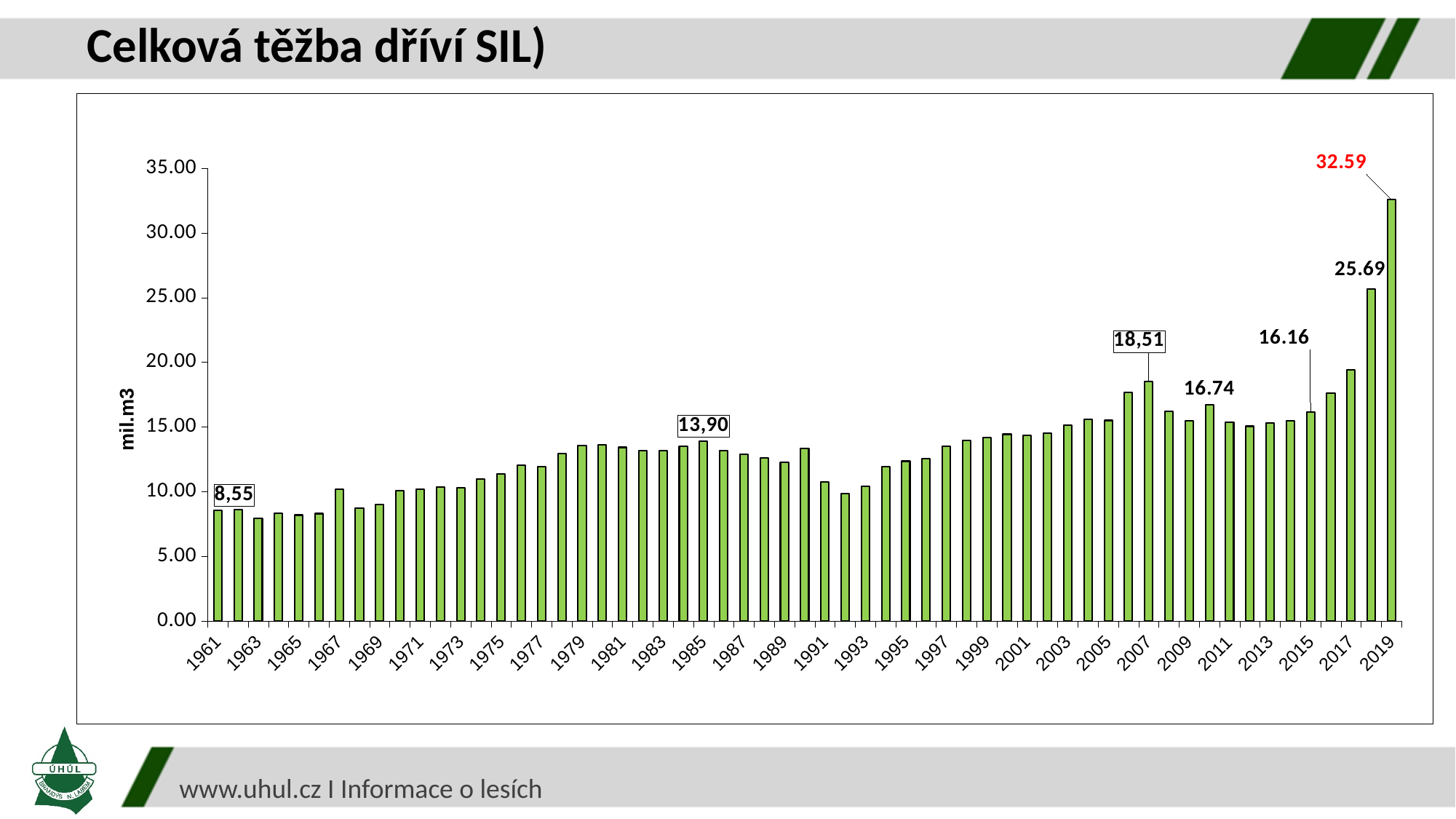
What is the value labelled for 1961? 8,55 What kind of chart is shown on the slide? bar chart What is the label on the vertical axis? mil.m3 Is the value for 1991 greater or less than 15.00? less What is the difference between the values for 2019 and 2018? 6.90 Which year has the larger value, 2007 or 2015? 2007 Do the values rise or fall from 2015 to 2019? rise What is the value labelled for 1985? 13,90 What is the value shown for 2019? 32.59 Which year has the highest total timber harvest in the chart? 2019 What is the value shown for 2018? 25.69 What is the value labelled for 2007? 18,51